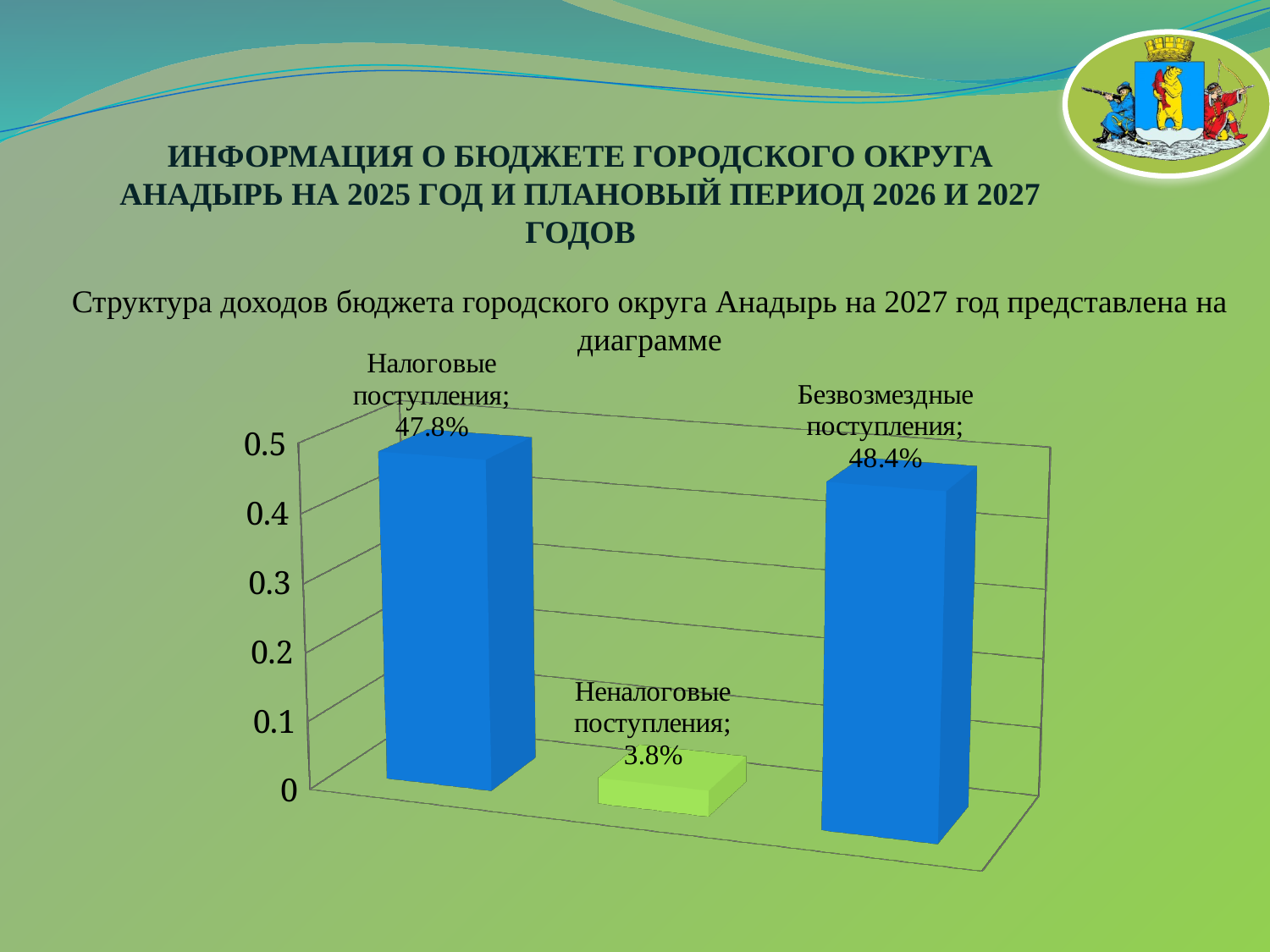
What is the value for Неналоговые поступления? 3.8% Which category has the lowest value? Неналоговые поступления Which is larger, Налоговые поступления or Неналоговые поступления? Налоговые поступления What is the value for Безвозмездные поступления? 48.4% How many categories are shown in the chart? 3 What colour is the bar for Неналоговые поступления? green What is the value for Налоговые поступления? 47.8% What kind of chart is shown on the slide? bar chart What is the difference between Налоговые поступления and Неналоговые поступления? 44% Is the value for Неналоговые поступления greater or less than 0.1? less Which category has the highest value? Безвозмездные поступления What is the difference between Безвозмездные поступления and Налоговые поступления? 0.6%